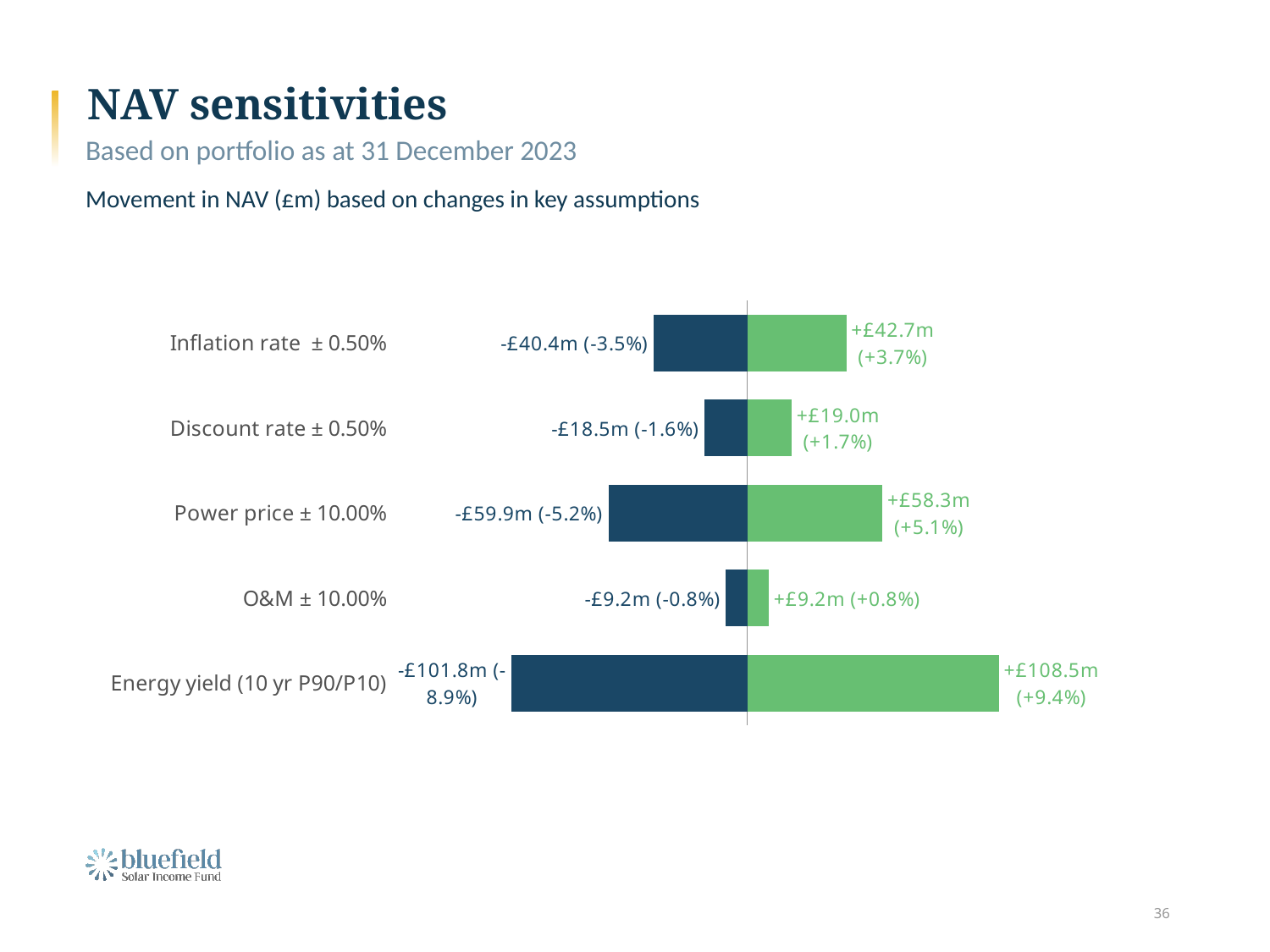
What is the positive NAV movement shown for Energy yield (10 yr P90/P10)? +£108.5m (+9.4%) What is the positive NAV movement shown for Inflation rate ± 0.50%? +£42.7m (+3.7%) What kind of chart is shown on the slide? Bar chart Which has a larger positive NAV movement: Inflation rate ± 0.50% or Discount rate ± 0.50%? Inflation rate ± 0.50% Which assumption has the smallest positive NAV movement? O&M ± 10.00% What is the negative NAV movement shown for Power price ± 10.00%? -£59.9m (-5.2%) What colour are the bars showing negative NAV movements? Dark blue What is the negative NAV movement shown for Discount rate ± 0.50%? -£18.5m (-1.6%) How many assumptions (categories) are shown in the chart? 5 How much larger is the positive NAV movement for Energy yield (10 yr P90/P10) than for Power price ± 10.00%, in £m? £50.2m What is the difference between the positive NAV movements for Inflation rate ± 0.50% and Discount rate ± 0.50%, in £m? £23.7m Which assumption has the largest positive NAV movement? Energy yield (10 yr P90/P10)